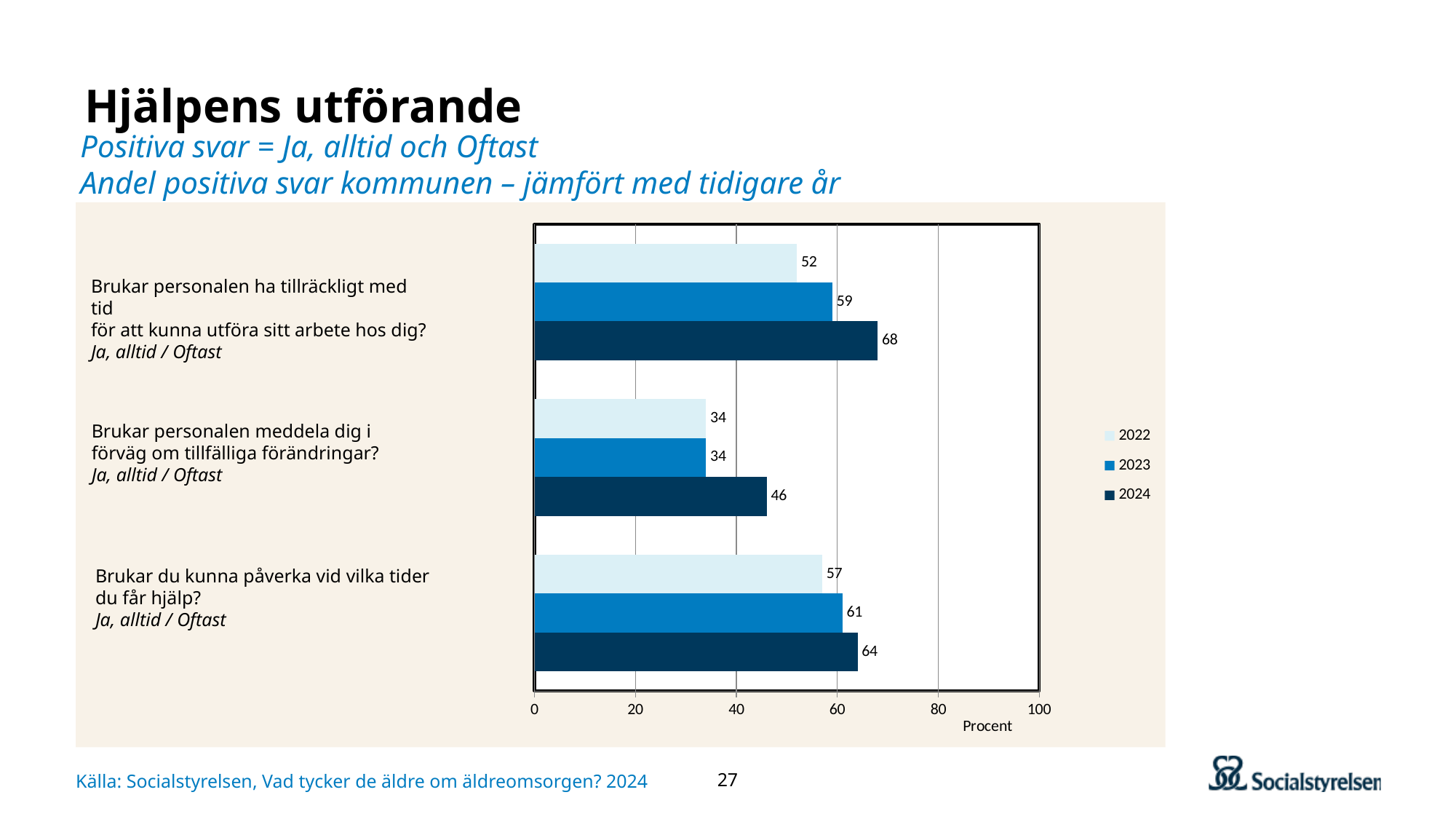
What is the difference between the 2024 and 2023 values for 'Brukar personalen meddela dig i förväg om tillfälliga förändringar?' 12 What is the label on the horizontal axis of the chart? Procent Which is larger: the 2022 value for 'Brukar du kunna påverka vid vilka tider du får hjälp?' or the 2022 value for 'Brukar personalen ha tillräckligt med tid för att kunna utföra sitt arbete hos dig?' Brukar du kunna påverka vid vilka tider du får hjälp? How many series does the legend list? 3 What is the difference between the 2024 and 2022 values for 'Brukar personalen ha tillräckligt med tid för att kunna utföra sitt arbete hos dig?' 16 What is the 2022 value for 'Brukar personalen meddela dig i förväg om tillfälliga förändringar?' 34 Which question has the highest 2024 value? Brukar personalen ha tillräckligt med tid för att kunna utföra sitt arbete hos dig? What is the 2023 value for 'Brukar du kunna påverka vid vilka tider du får hjälp?' 61 What kind of chart is shown on the slide? Bar chart How many questions (categories) are shown on the chart? 3 Which question has the lowest 2022 value? Brukar personalen meddela dig i förväg om tillfälliga förändringar? What is the 2024 value for 'Brukar personalen ha tillräckligt med tid för att kunna utföra sitt arbete hos dig?' 68